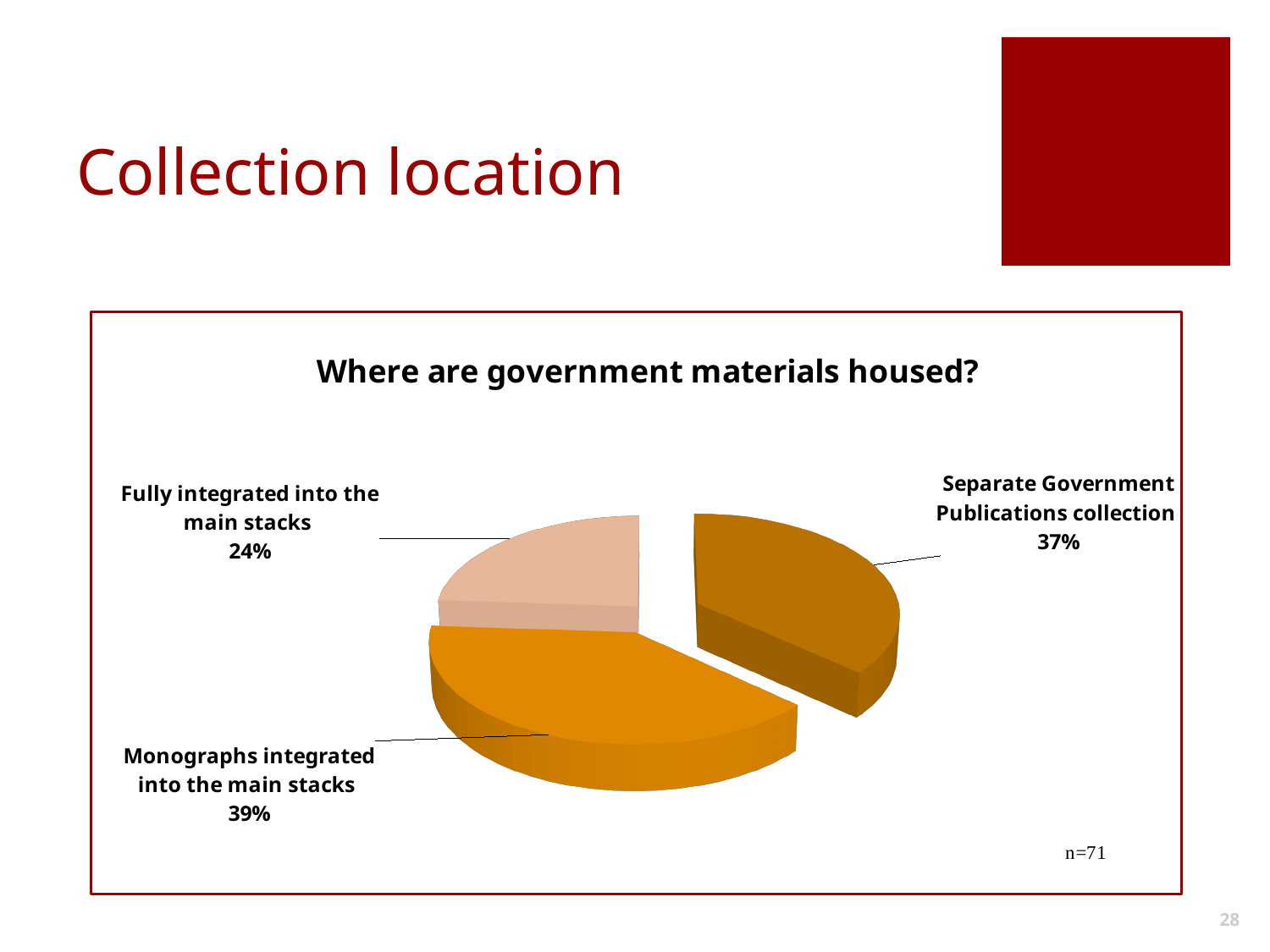
What is the chart's title? Where are government materials housed? What share of the pie is 'Monographs integrated into the main stacks'? 39% Which is larger: the share for 'Separate Government Publications collection' or for 'Fully integrated into the main stacks'? Separate Government Publications collection What share of the pie is 'Fully integrated into the main stacks'? 24% What sample size (n) is noted on the chart? n=71 Which category has the smallest share of the pie? Fully integrated into the main stacks Which category has the largest share of the pie? Monographs integrated into the main stacks What is the difference in percentage points between 'Monographs integrated into the main stacks' and 'Fully integrated into the main stacks'? 15 How many slices does the pie chart have? 3 What is the difference in percentage points between 'Separate Government Publications collection' and 'Fully integrated into the main stacks'? 13 What share of the pie is 'Separate Government Publications collection'? 37% What kind of chart is shown on the slide? pie chart